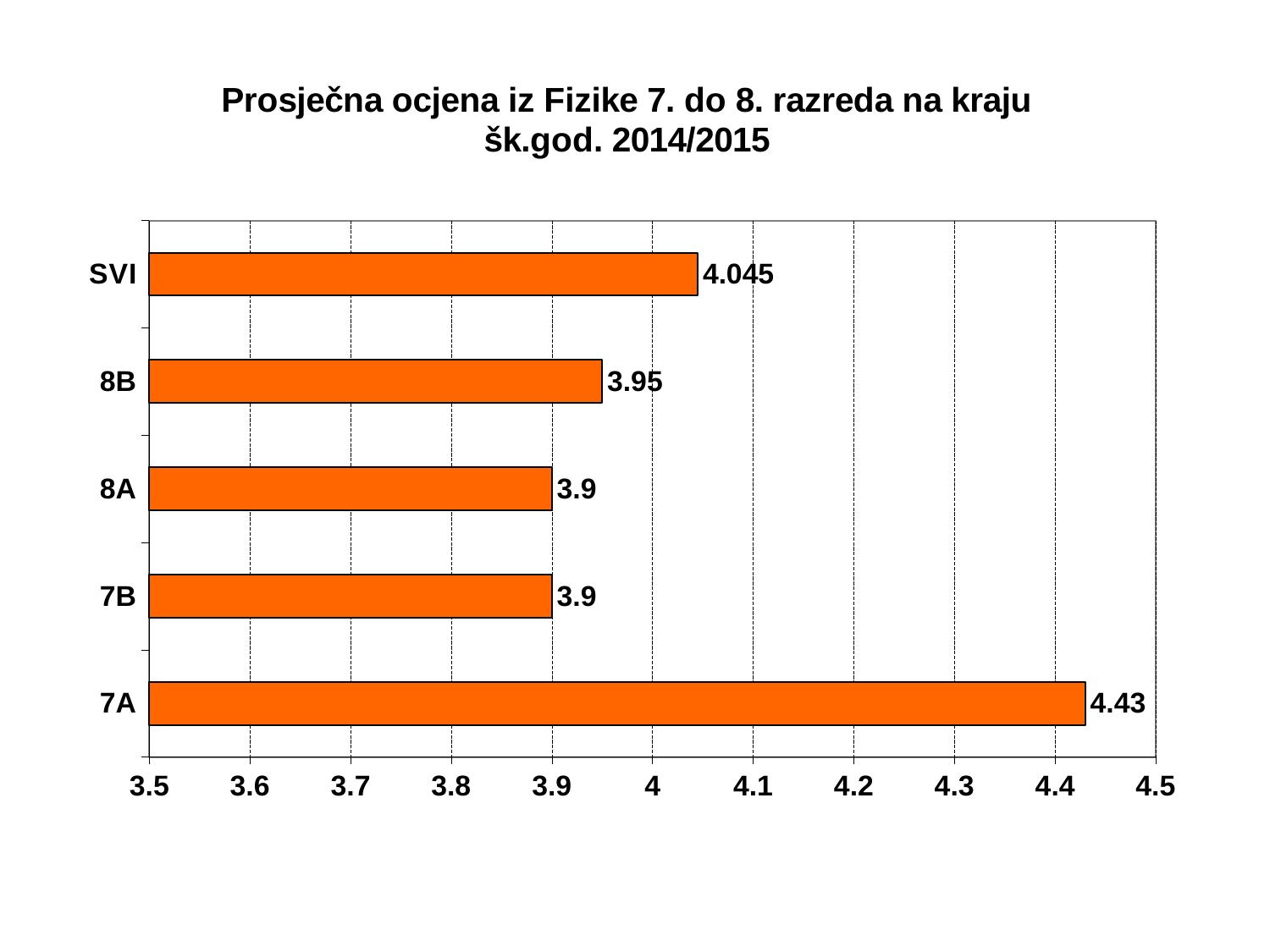
What is the difference between the values for 7A and 8B? 0.48 How many categories are shown in the chart? 5 What is the title of the chart? Prosječna ocjena iz Fizike 7. do 8. razreda na kraju šk.god. 2014/2015 Is the value for 7A greater or less than 4.4? greater Is the value for 8B greater or less than 4? less What is the difference between the values for SVI and 8A? 0.145 What is the average grade for class 8B? 3.95 What is the average Physics grade for class 7A? 4.43 Which is larger, the value for 8B or the value for 7B? 8B What kind of chart is shown on the slide? bar chart What is the value shown for SVI? 4.045 Which category has the highest average grade? 7A